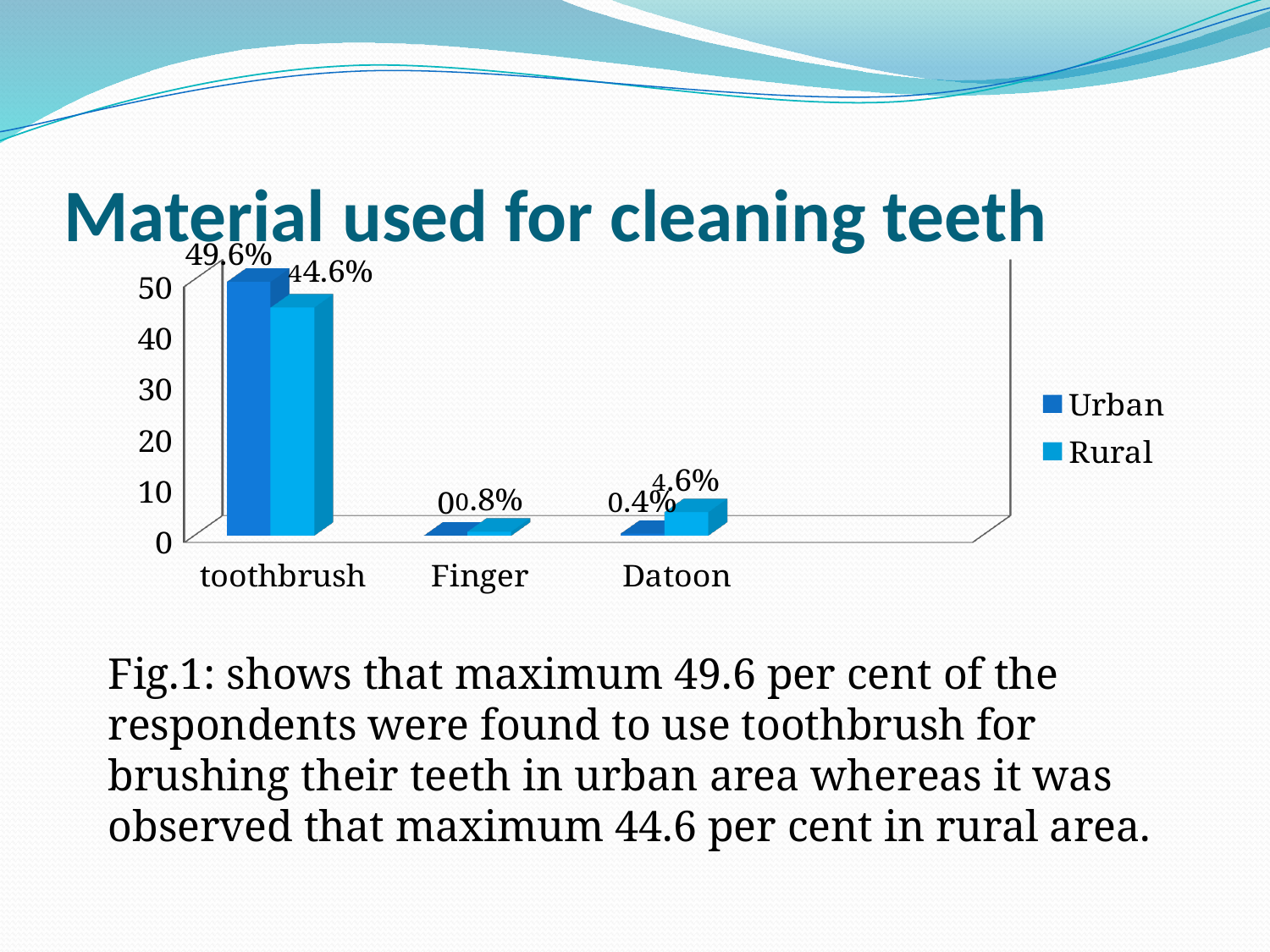
What kind of chart is shown on the slide? bar chart How many series does the legend list? 2 Which category has the highest Rural value? toothbrush How many categories are shown on the x axis? 3 What is the difference between the Urban and Rural values for toothbrush? 5% Which category has the lowest Urban value? Finger Which is larger for Datoon, the Urban value or the Rural value? Rural What is the Urban value for toothbrush? 49.6% What is the Urban value for Datoon? 0.4% What is the Rural value for Finger? 0.8% What is the Rural value for Datoon? 4.6% What is the Rural value for toothbrush? 44.6%